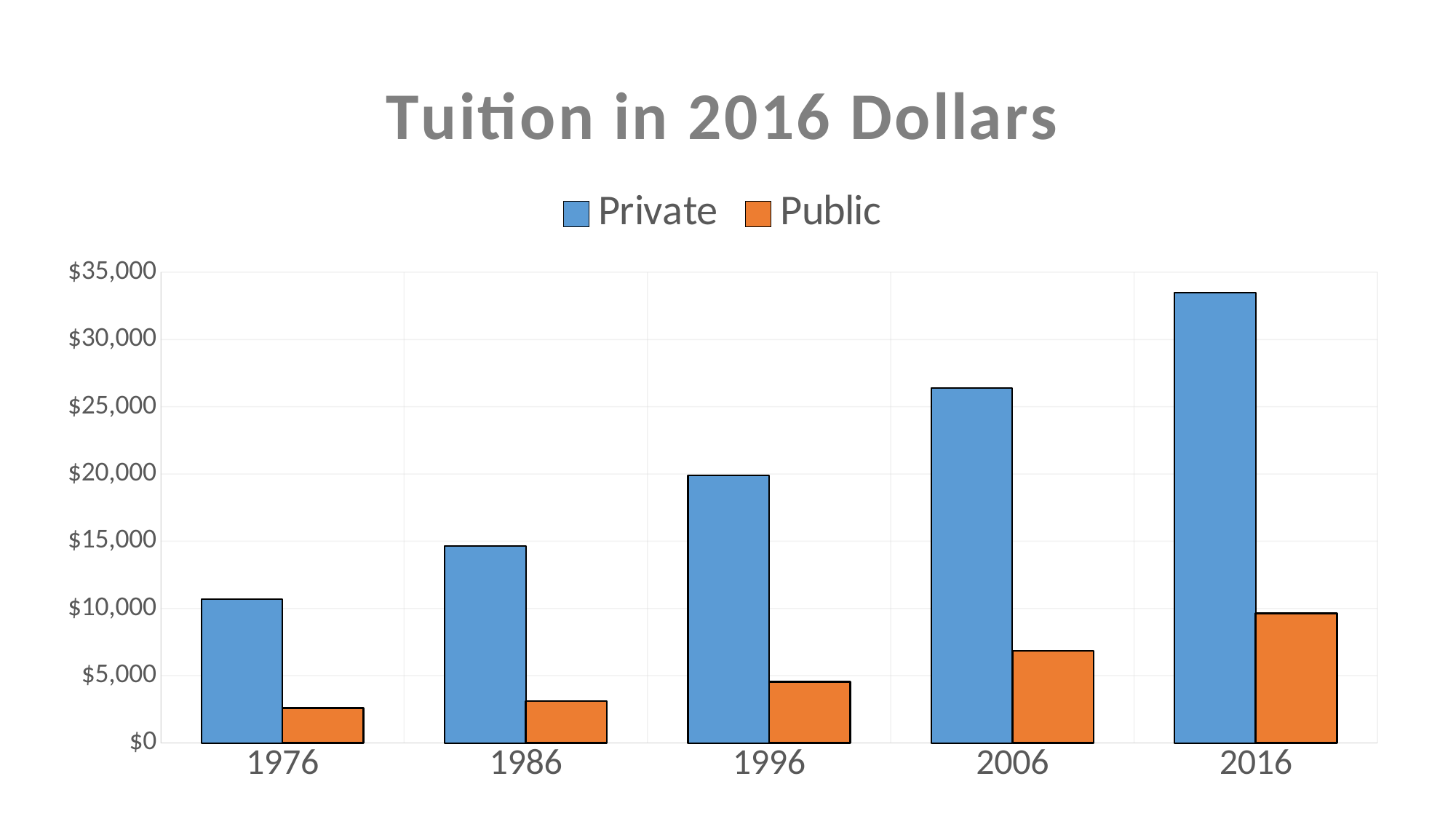
What is the title of the chart? Tuition in 2016 Dollars How many series does the legend list? 2 Which year has the highest Private tuition? 2016 What type of chart is shown on the slide? bar chart Is the Public tuition for 1976 greater or less than $5,000? less Is the Public tuition for 2006 greater or less than $5,000? greater Does Public tuition rise or fall from 1976 to 2016? rise Which year has the lowest Public tuition? 1976 How many years are shown on the x axis? 5 Which is larger in 2016, Private tuition or Public tuition? Private Is the Private tuition for 2016 greater or less than $30,000? greater